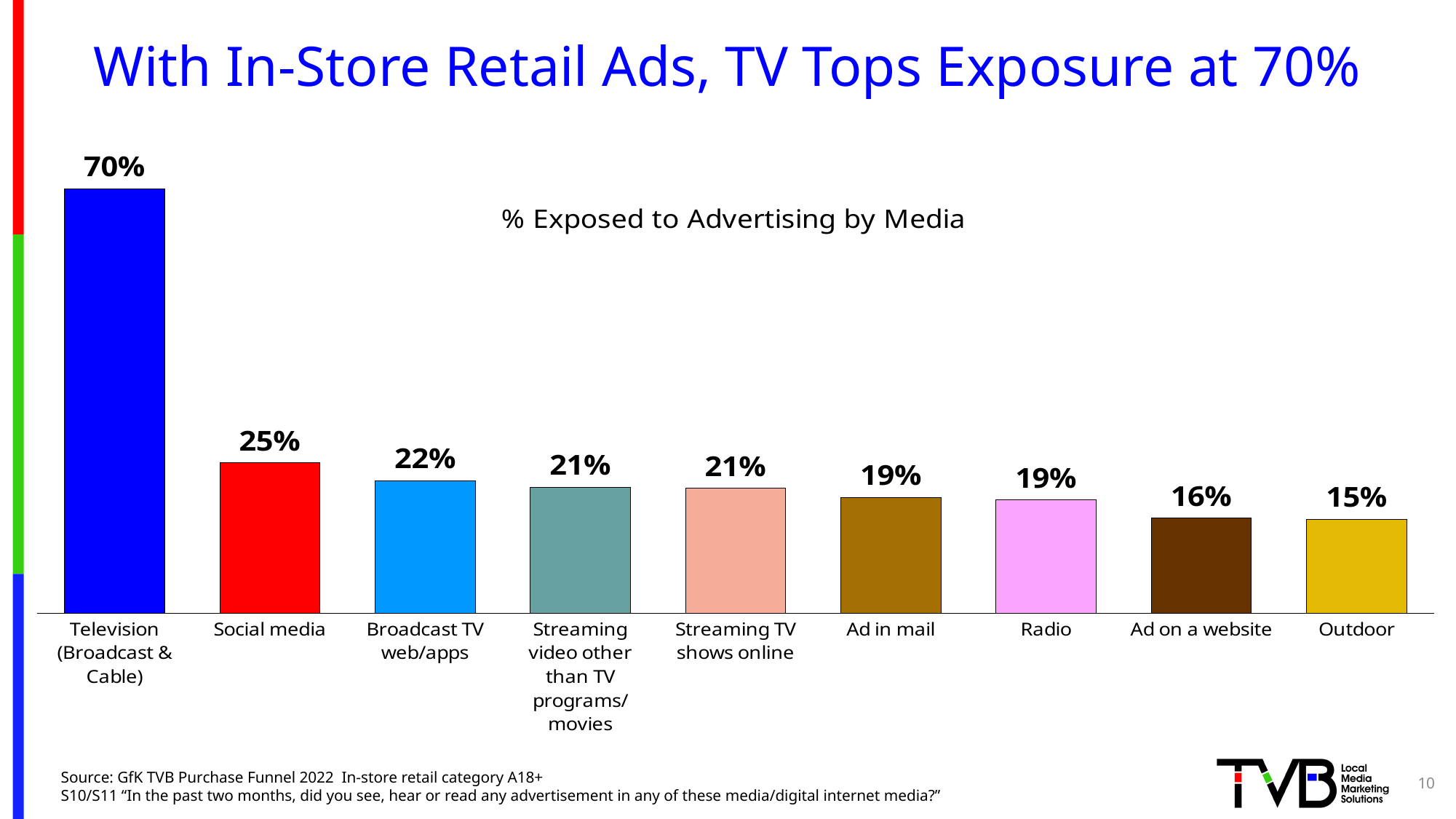
Which is larger, the value for Social media or the value for Ad in mail? Social media What kind of chart is shown on the slide? Bar chart How many media categories are shown in the chart? 9 What is the difference between the values for Television (Broadcast & Cable) and Social media? 45% What is the value for Social media? 25% Which media category has the lowest percentage exposed to advertising? Outdoor What is the value for Ad on a website? 16% What is the value for Television (Broadcast & Cable)? 70% Which media category has the highest percentage exposed to advertising? Television (Broadcast & Cable) What is the title of the chart? % Exposed to Advertising by Media What is the value for Radio? 19% What is the difference between the values for Broadcast TV web/apps and Outdoor? 7%